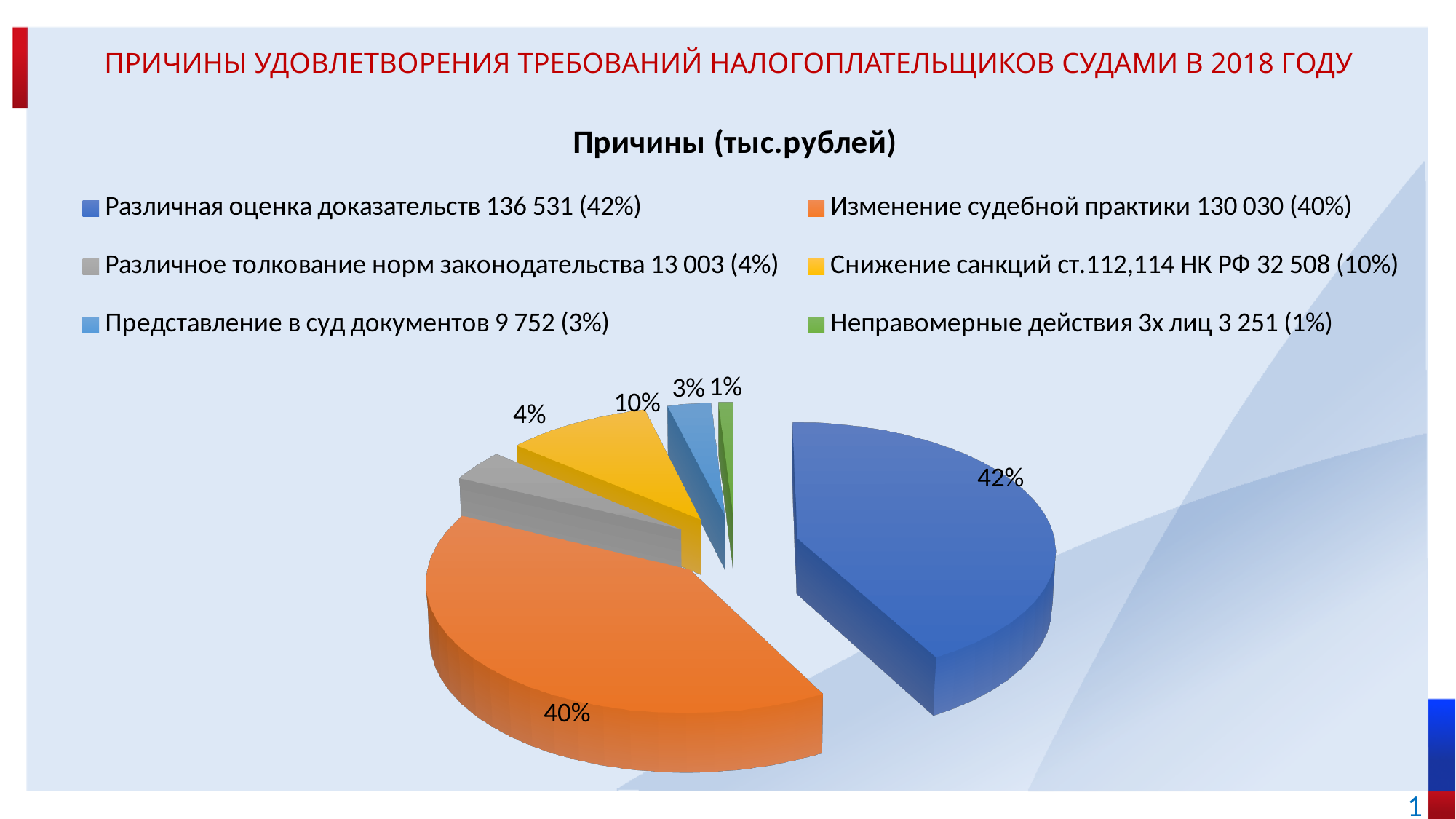
What is the value for Снижение санкций ст.112,114 НК РФ? 32 508 Which category has the smallest share of the pie? Неправомерные действия 3х лиц Which is larger: the value for Снижение санкций ст.112,114 НК РФ or the value for Различное толкование норм законодательства? Снижение санкций ст.112,114 НК РФ Which category has the largest share of the pie? Различная оценка доказательств What is the title of the chart? Причины (тыс.рублей) What share of the pie does Изменение судебной практики represent? 40% What is the difference between the values for Различная оценка доказательств and Изменение судебной практики? 6 501 What is the value for Представление в суд документов? 9 752 What share of the pie does Различное толкование норм законодательства represent? 4% What is the value for Различная оценка доказательств? 136 531 What kind of chart is shown on the slide? pie chart How many categories does the pie chart have? 6